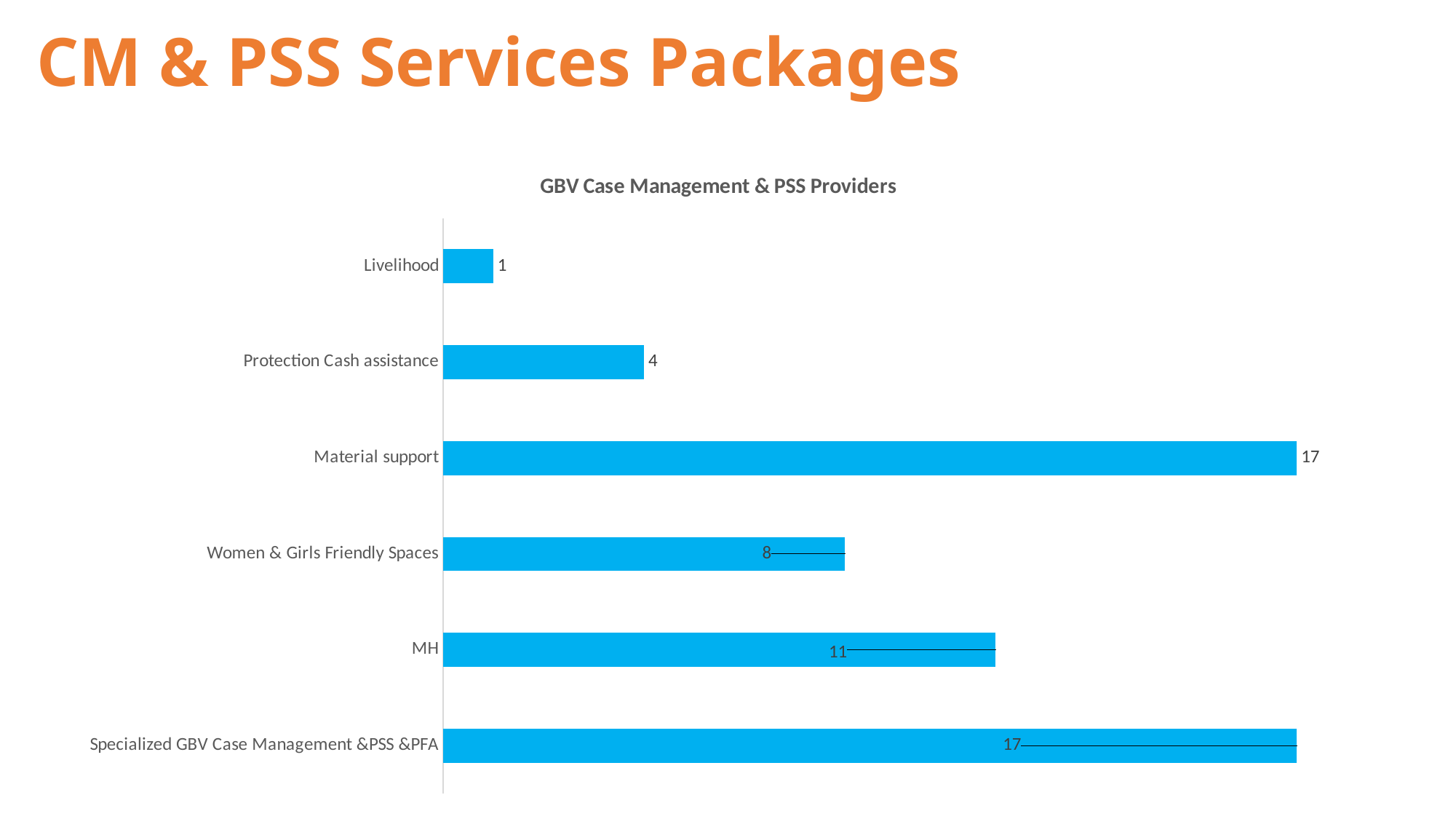
Which category has the lowest value? Livelihood What is the difference between the values for Material support and Protection Cash assistance? 13 What is the value for Livelihood? 1 What is the value for Protection Cash assistance? 4 What is the difference between the values for MH and Women & Girls Friendly Spaces? 3 Which is larger, the value for MH or the value for Protection Cash assistance? MH What is the value for Women & Girls Friendly Spaces? 8 What is the title of the chart? GBV Case Management & PSS Providers What kind of chart is shown on the slide? Bar chart How many categories are shown in the chart? 6 What is the value for MH? 11 What is the value for Material support? 17